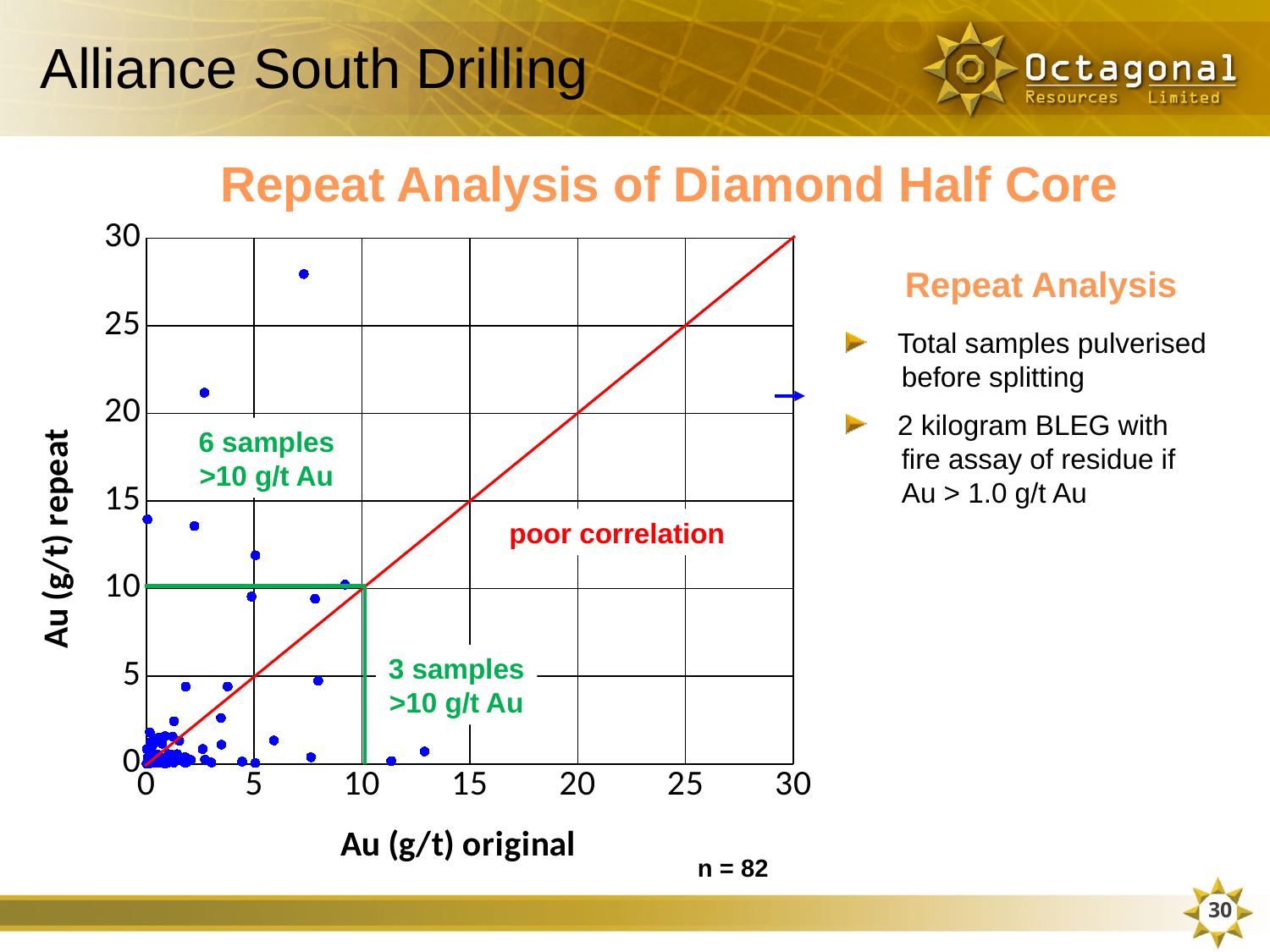
According to the annotation, how many samples have a repeat value above 10 g/t Au? 6 What does the red annotation on the chart say about the relationship between original and repeat values? poor correlation Is the highest repeat value plotted greater or less than 20? greater According to the annotation, how many samples have an original value above 10 g/t Au? 3 What is the maximum value shown on the y axis? 30 What is the title of the chart? Repeat Analysis of Diamond Half Core What is the maximum value shown on the x axis? 30 Is the highest repeat value plotted greater or less than 25? greater How many samples are plotted in the chart, according to the n value shown? 82 What kind of chart is shown on the slide? scatter chart